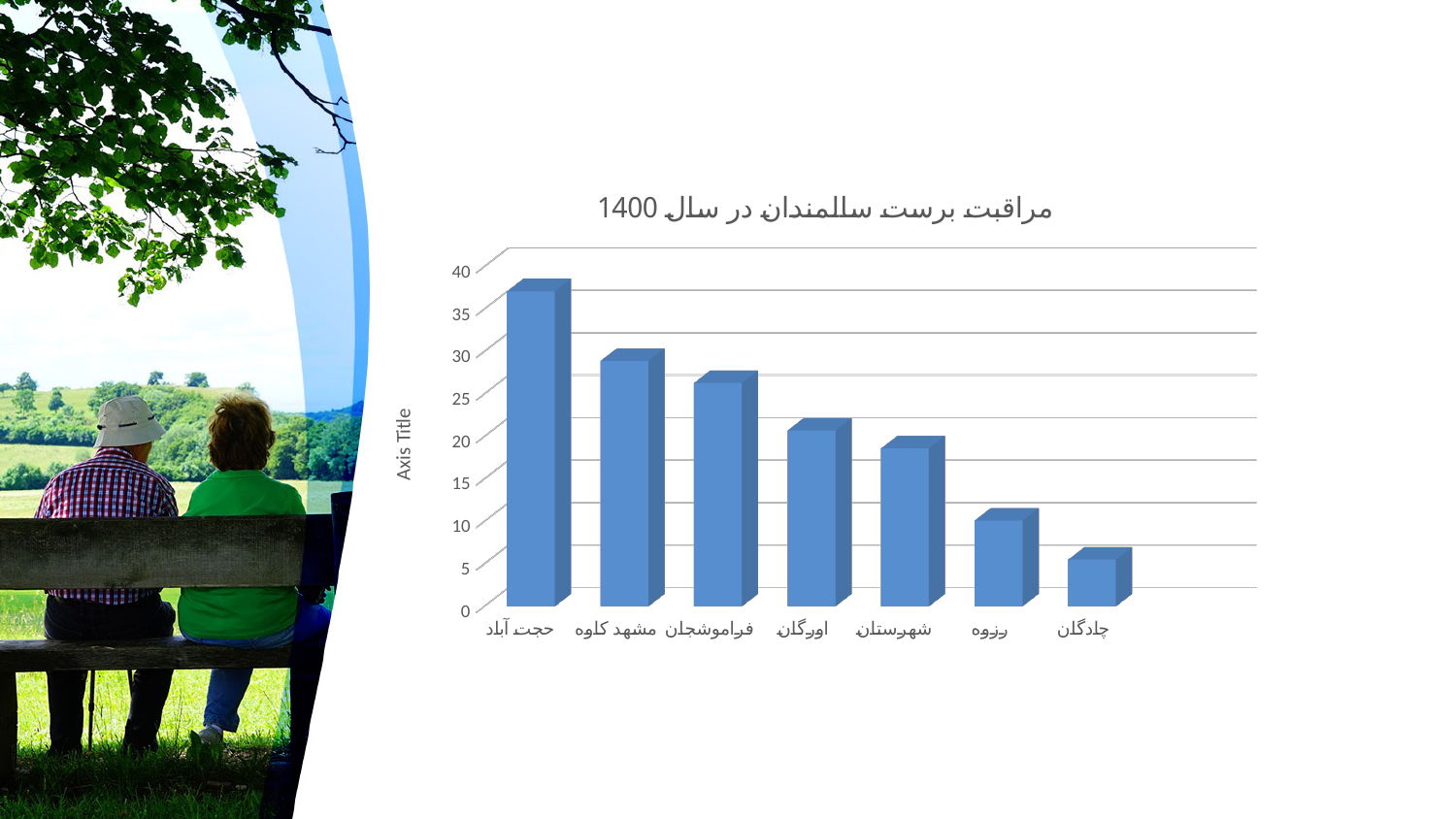
Which category has the lowest value? چادگان How many categories are plotted on the chart? 7 Is the value for فراموشجان greater or less than 20? greater Is the value for حجت آباد greater or less than 35? greater What kind of chart is shown on the slide? bar chart Is the value for مشهد کاوه greater or less than 25? greater Do the values rise or fall moving from left to right along the x axis? fall Which category has the highest value? حجت آباد Which has the larger value, مشهد کاوه or شهرستان? مشهد کاوه